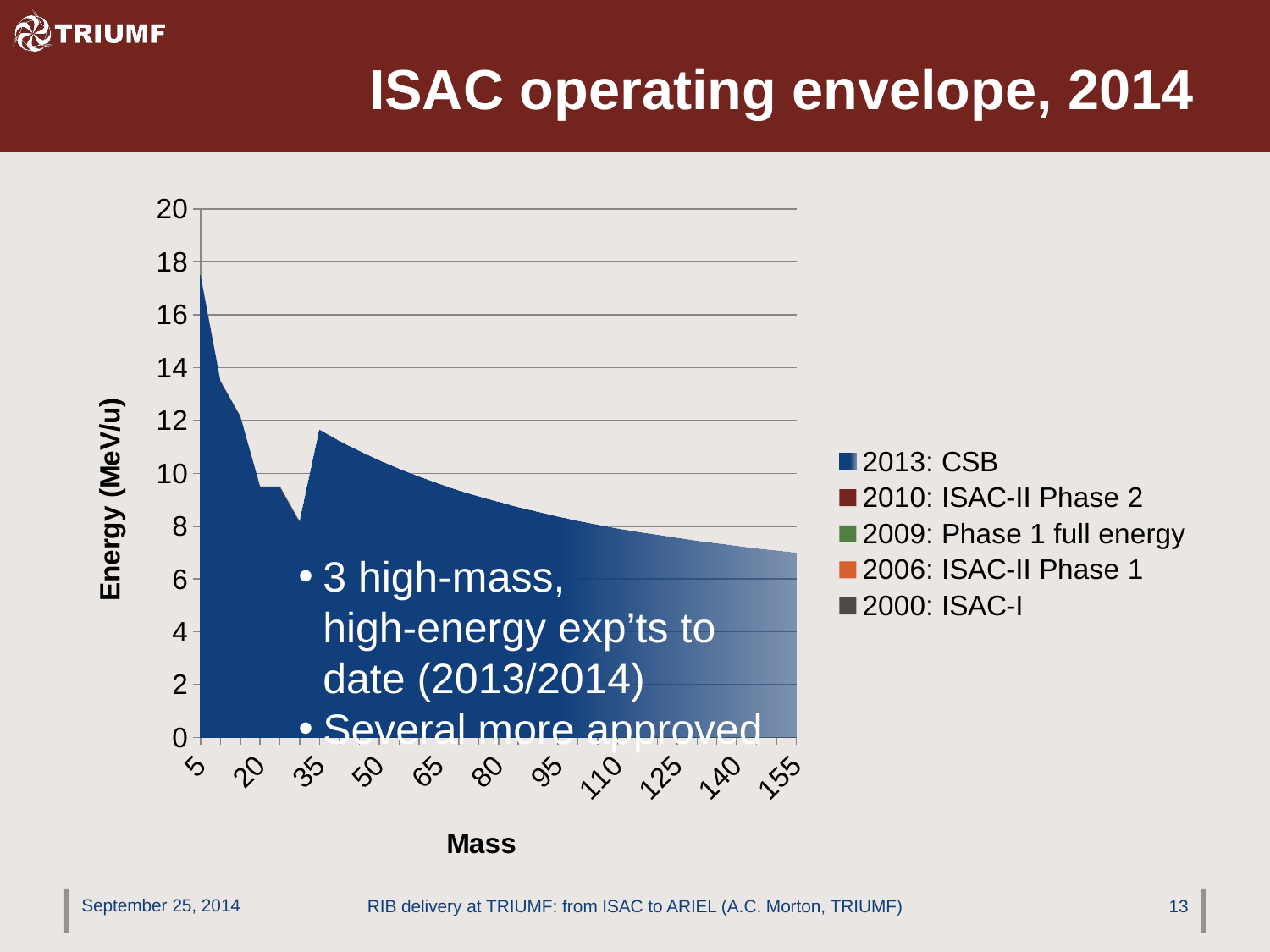
Is the energy value at mass 155 greater or less than 8? less At which mass tick is the energy highest? 5 Which has the larger energy value, mass 5 or mass 155? Mass 5 At which mass tick is the energy lowest? 155 Is the energy value at mass 20 greater or less than 12? less What is the label of the y axis? Energy (MeV/u) What is the title of the chart on the slide? ISAC operating envelope, 2014 Is the energy value at mass 5 greater or less than 16? greater How many series does the legend list? 5 Overall, does the energy rise or fall as mass increases along the x axis? Fall What kind of chart is shown on the slide? Area chart